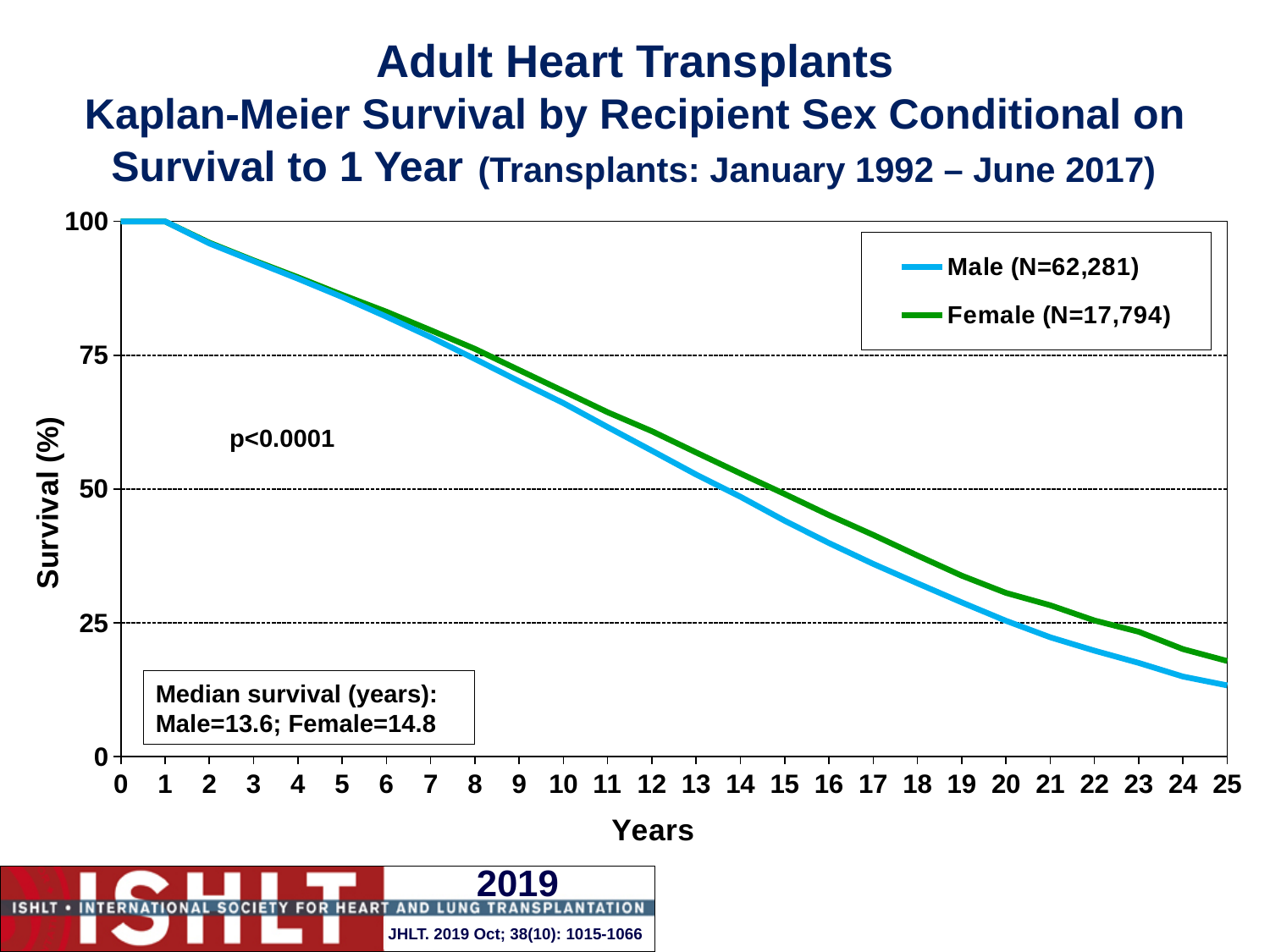
What is the median survival in years for female recipients? 14.8 What p-value is shown on the chart? p<0.0001 What is the median survival in years for male recipients? 13.6 What kind of chart is shown on the slide? line chart Do the survival curves rise or fall as years increase? fall Is the Male survival value at 25 years greater or less than 25? less How many series does the legend list? 2 What is the difference in median survival (years) between female and male recipients? 1.2 Which recipient sex has the longer median survival? Female What is the number of male recipients (N) shown in the legend? 62,281 At 20 years, which series shows higher survival, Male or Female? Female Is the Female survival value at 10 years greater or less than 50? greater